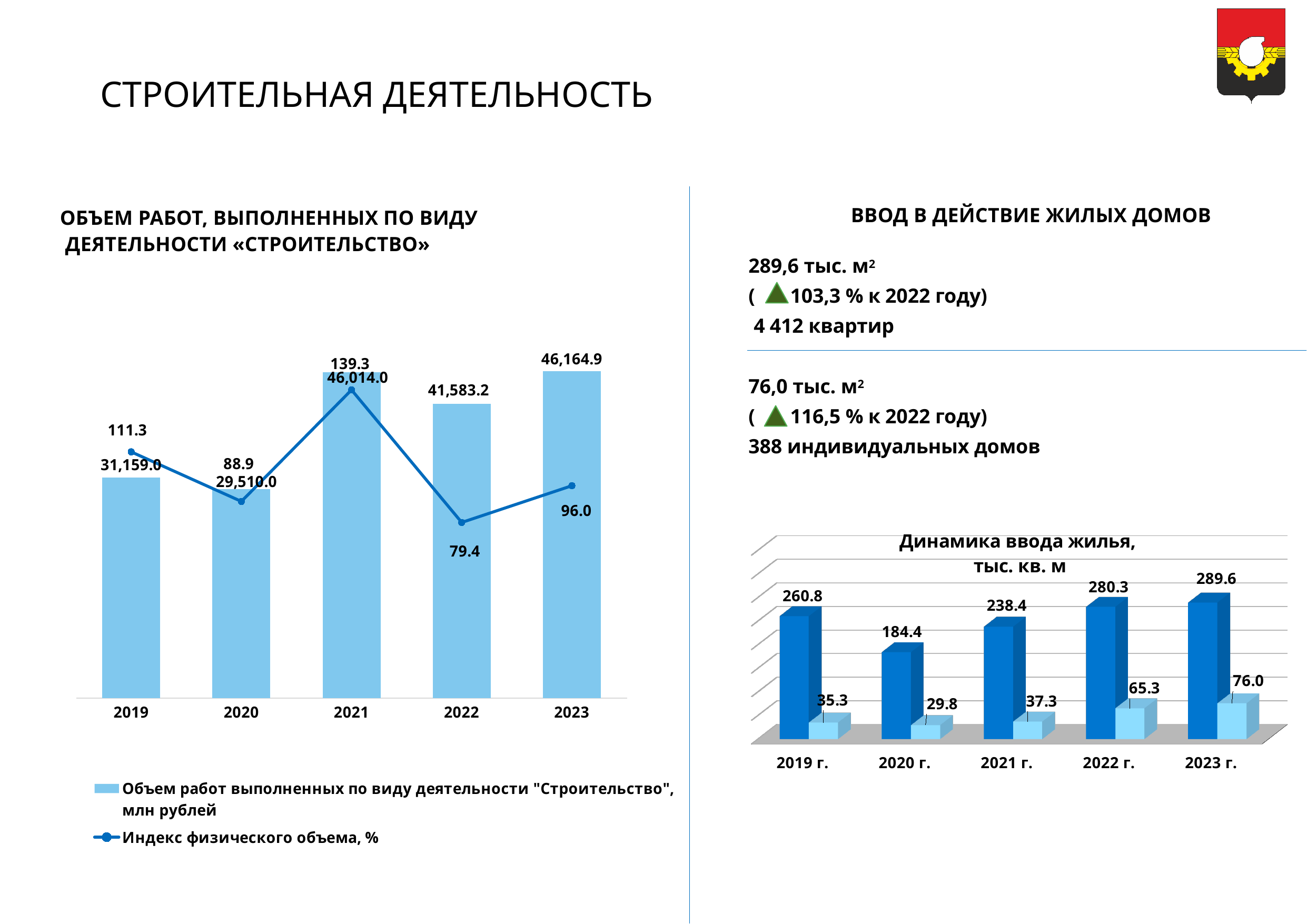
In the left chart, which year has the lowest bar value? 2020 In the left chart, how many series does the legend list? 2 In the left chart, what kind of chart is used for the series 'Объем работ выполненных по виду деятельности "Строительство", млн рублей'? Bar chart In the right chart (Динамика ввода жилья, тыс. кв. м), which year has the highest dark blue bar? 2023 г. In the right chart (Динамика ввода жилья, тыс. кв. м), what is the value of the dark blue bar for 2022 г.? 280.3 In the left chart, what is the value of the line (Индекс физического объема, %) for 2021? 139.3 In the right chart (Динамика ввода жилья, тыс. кв. м), how many years are shown on the x axis? 5 In the right chart (Динамика ввода жилья, тыс. кв. м), do the light blue bars rise or fall from 2021 г. to 2023 г.? Rise In the left chart (Объем работ, выполненных по виду деятельности «Строительство»), what is the value of the bar for 2023? 46,164.9 In the left chart, which year has the lowest value on the line (Индекс физического объема, %)? 2022 In the right chart (Динамика ввода жилья, тыс. кв. м), what is the value of the light blue bar for 2020 г.? 29.8 In the left chart, what is the difference between the bar values for 2023 and 2022? 4,581.7